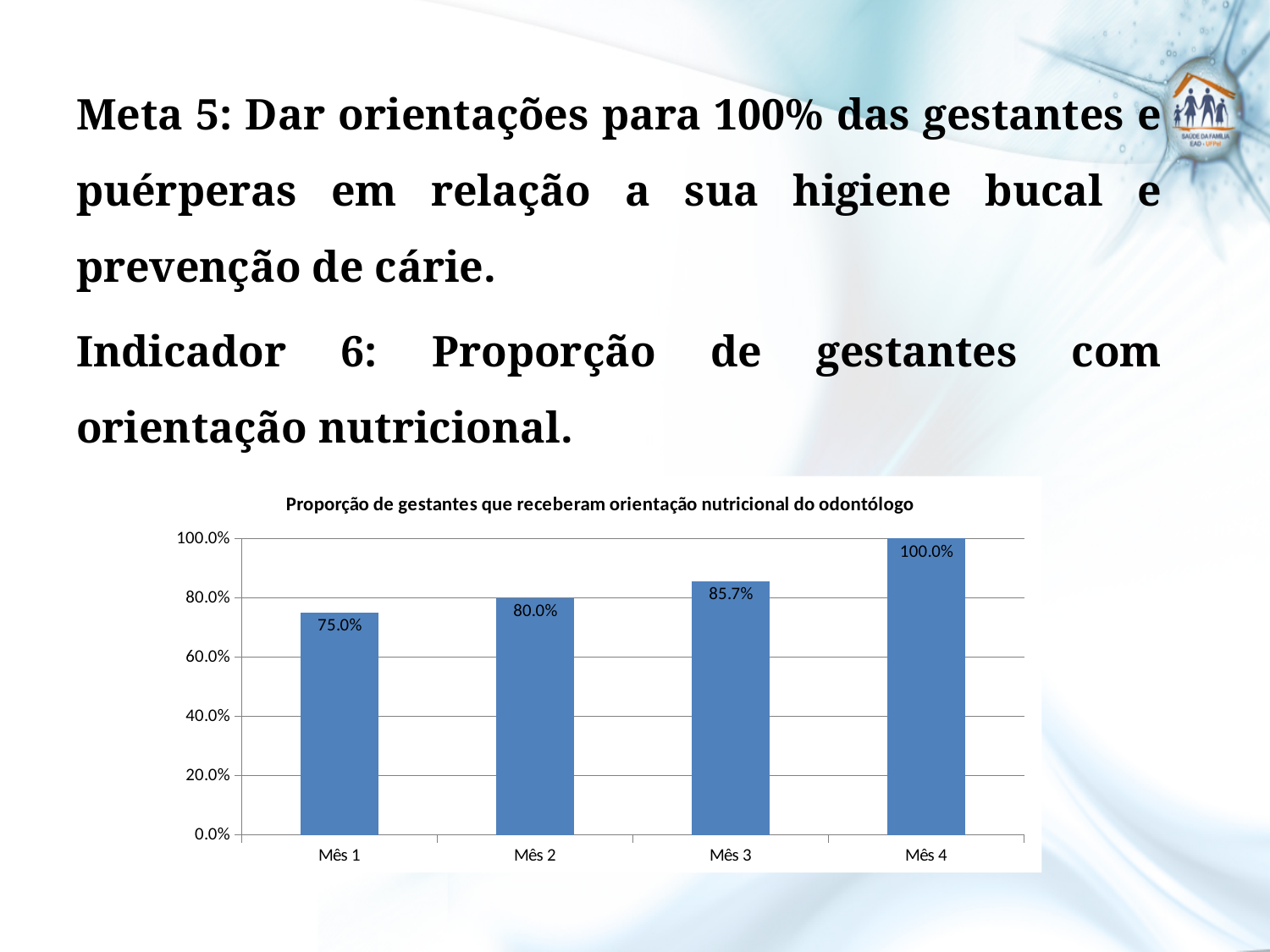
Which is larger, the value for Mês 2 or the value for Mês 3? Mês 3 What is the value for Mês 1? 75.0% Do the values rise or fall from Mês 1 to Mês 4? Rise How many months are shown on the x axis? 4 What is the difference between the values for Mês 4 and Mês 1? 25.0% Which month has the highest value? Mês 4 What is the difference between the values for Mês 3 and Mês 2? 5.7% What kind of chart is shown on the slide? Bar chart Which month has the lowest value? Mês 1 What is the value for Mês 4? 100.0% Is the value for Mês 2 greater or less than 60.0%? greater What is the value for Mês 3? 85.7%